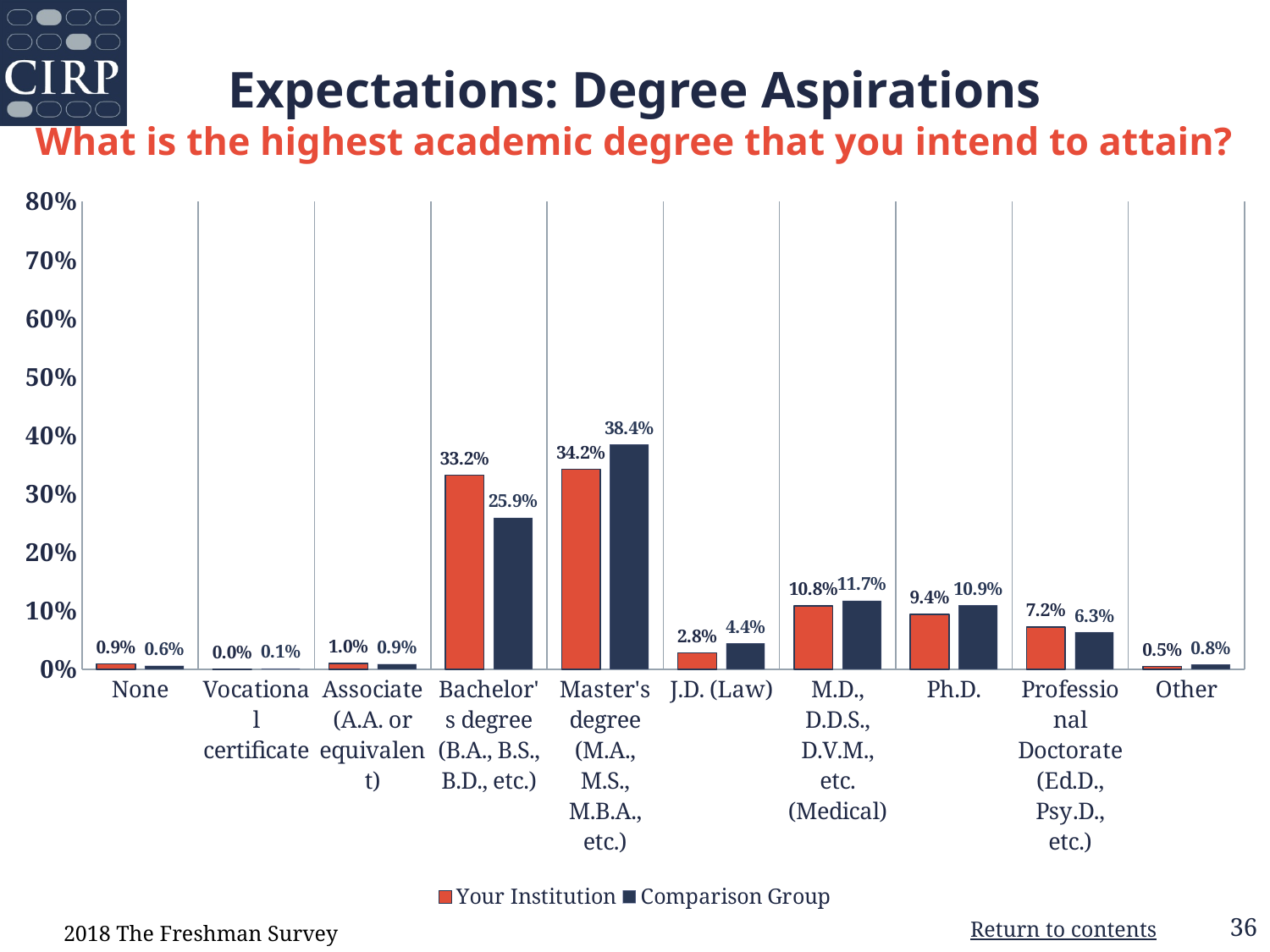
Which category has the lowest value for Your Institution? Vocational certificate What is the value for Your Institution for Ph.D.? 9.4% What is the difference between Your Institution and Comparison Group for Bachelor's degree (B.A., B.S., B.D., etc.)? 7.3% What is the difference between Comparison Group and Your Institution for Ph.D.? 1.5% Which is larger for J.D. (Law): Your Institution or Comparison Group? Comparison Group How many series does the legend list? 2 What is the value for Comparison Group for Bachelor's degree (B.A., B.S., B.D., etc.)? 25.9% Is the value for Your Institution for Master's degree greater or less than 30%? greater What is the value for Your Institution for Master's degree (M.A., M.S., M.B.A., etc.)? 34.2% Which category has the highest value for Comparison Group? Master's degree (M.A., M.S., M.B.A., etc.) How many categories are shown on the x axis? 10 What kind of chart is shown on the slide? Bar chart